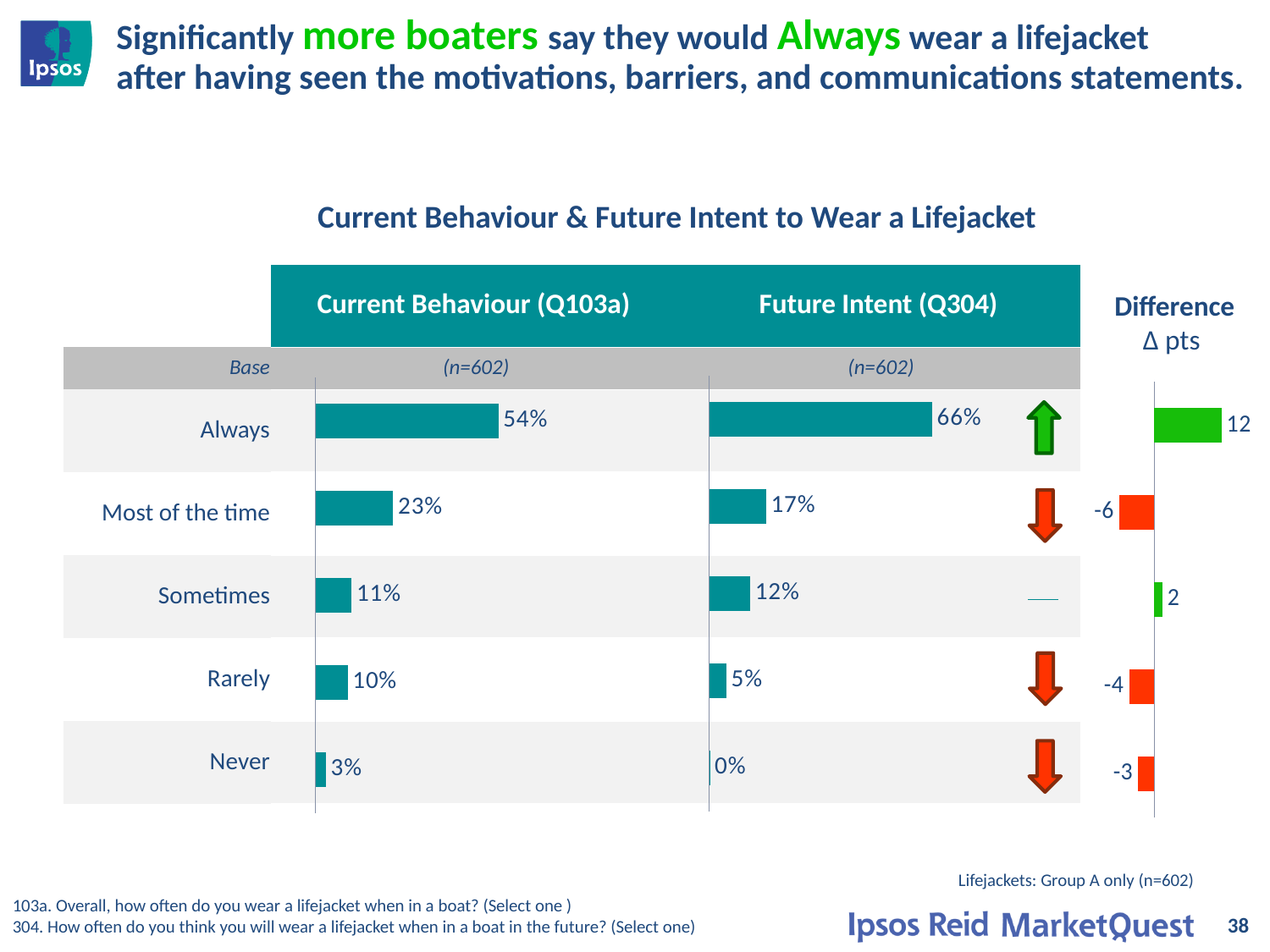
What is the base sample size (n) shown for the Future Intent (Q304) chart? n=602 In the Difference chart, what is the value shown for Always? 12 How many response categories are shown in the Current Behaviour (Q103a) chart? 5 In the Current Behaviour (Q103a) chart, which category has the lowest value? Never Which is larger: the Current Behaviour value for Sometimes or the Future Intent value for Sometimes? Future Intent (12%) In the Difference chart, what is the value shown for Never? -3 In the Future Intent (Q304) chart, what is the value for Rarely? 5% In the Future Intent (Q304) chart, which category has the highest value? Always In the Future Intent (Q304) chart, what percentage of boaters say they will Always wear a lifejacket? 66% What is the difference between the Future Intent and Current Behaviour values for Most of the time? -6 In the Current Behaviour (Q103a) chart, what percentage of boaters say they Always wear a lifejacket? 54% What type of chart is used to show Current Behaviour (Q103a)? Bar chart